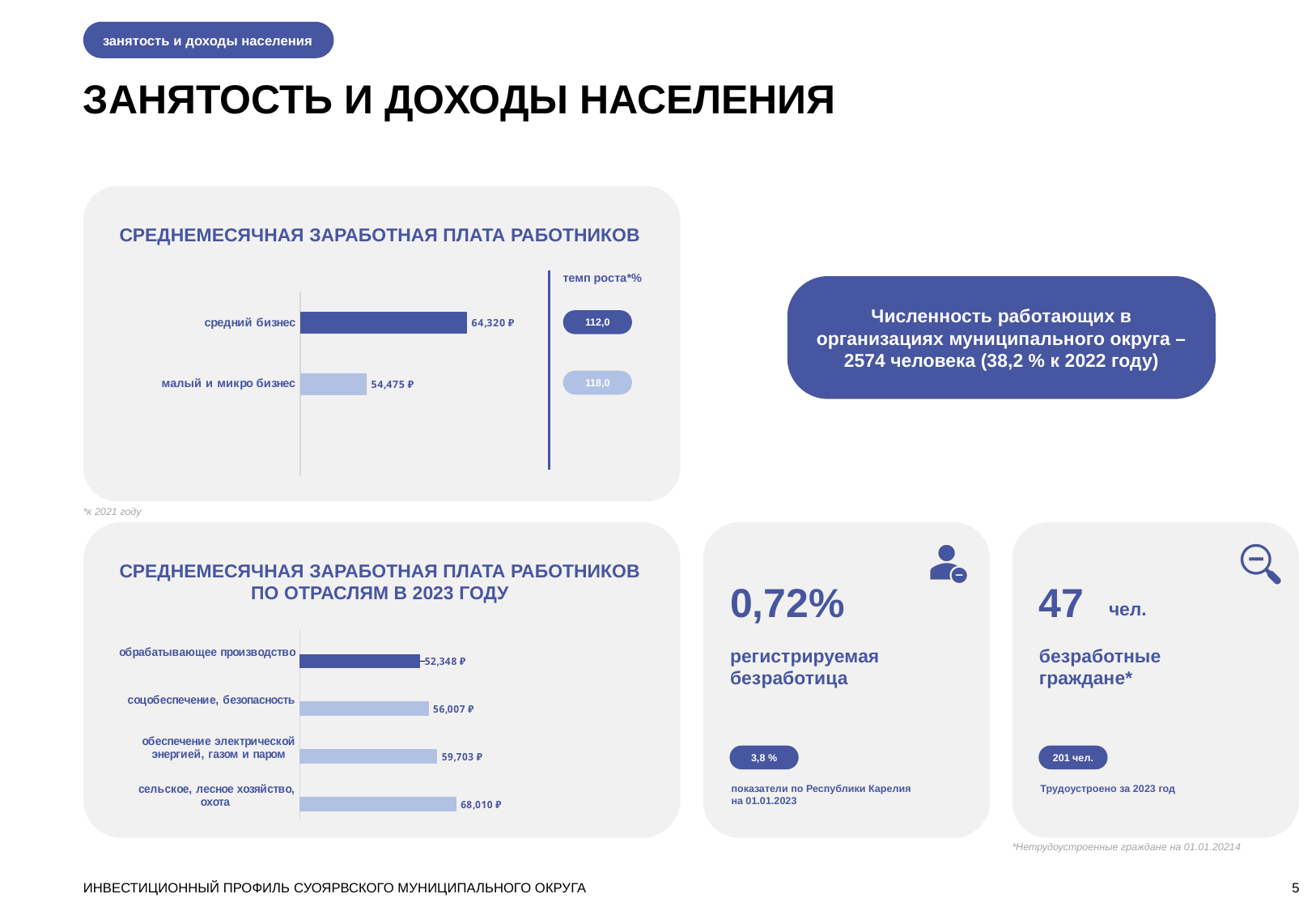
In the chart 'Среднемесячная заработная плата работников', what is the 'темп роста' value shown for 'малый и микро бизнес'? 118,0 In the chart 'Среднемесячная заработная плата работников', what is the value for 'малый и микро бизнес'? 54,475 ₽ In the chart 'Среднемесячная заработная плата работников по отраслям в 2023 году', what is the difference between the values for 'сельское, лесное хозяйство, охота' and 'обрабатывающее производство'? 15,662 ₽ In the chart 'Среднемесячная заработная плата работников по отраслям в 2023 году', which category has the highest value? сельское, лесное хозяйство, охота In the chart 'Среднемесячная заработная плата работников', how many categories are plotted? 2 In the chart 'Среднемесячная заработная плата работников по отраслям в 2023 году', which category has the lowest value? обрабатывающее производство In the chart 'Среднемесячная заработная плата работников', what is the difference between the values for 'средний бизнес' and 'малый и микро бизнес'? 9,845 ₽ In the chart 'Среднемесячная заработная плата работников по отраслям в 2023 году', which is larger: the value for 'соцобеспечение, безопасность' or for 'обеспечение электрической энергией, газом и паром'? обеспечение электрической энергией, газом и паром In the chart 'Среднемесячная заработная плата работников по отраслям в 2023 году', what is the value for 'обеспечение электрической энергией, газом и паром'? 59,703 ₽ In the chart 'Среднемесячная заработная плата работников по отраслям в 2023 году', how many categories are plotted? 4 What kind of chart is 'Среднемесячная заработная плата работников по отраслям в 2023 году'? Bar chart In the chart 'Среднемесячная заработная плата работников', what is the value for 'средний бизнес'? 64,320 ₽